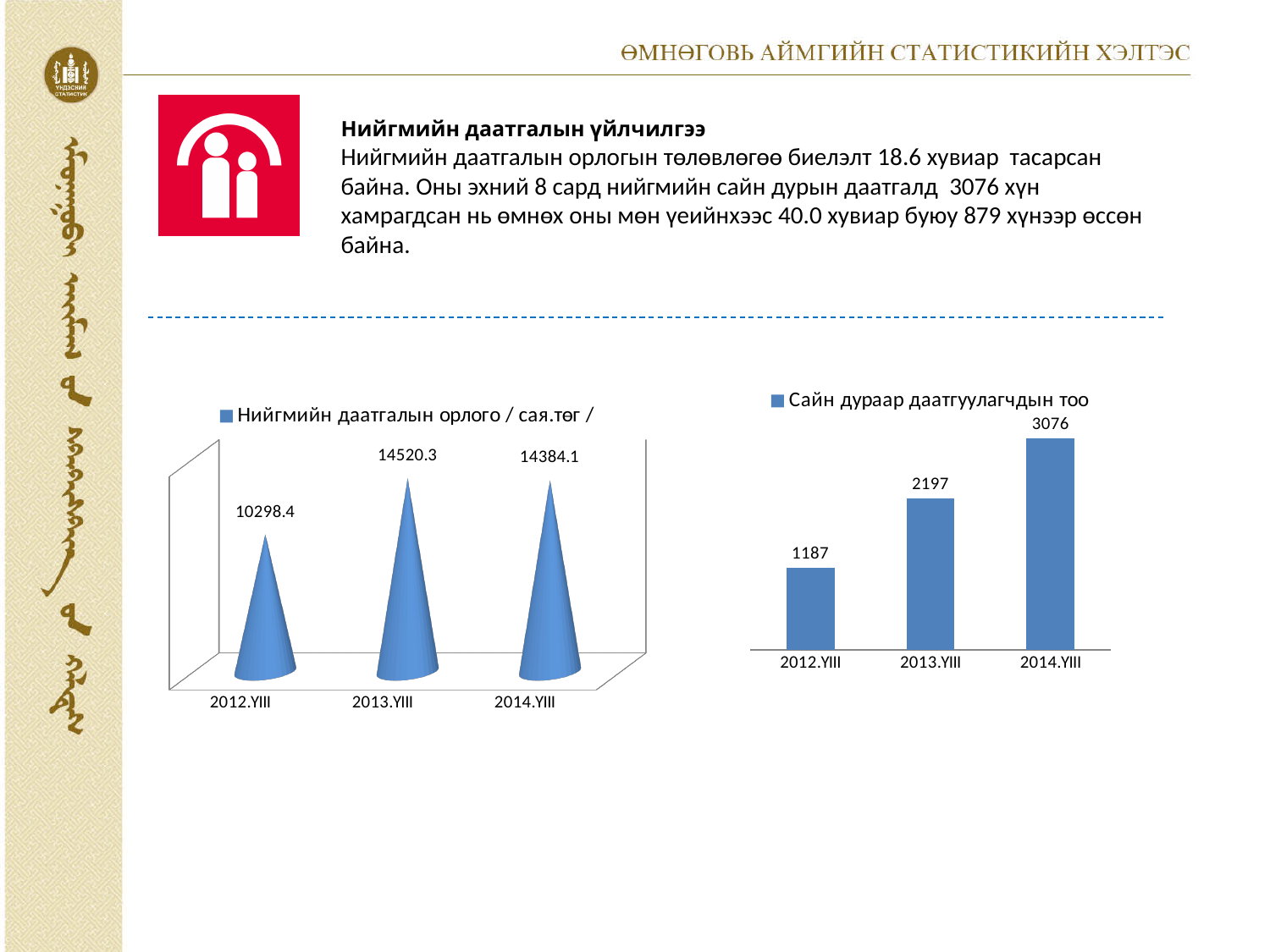
In the left chart (Нийгмийн даатгалын орлого / сая.төг /), which period has the lowest value? 2012.YIII In the left chart (Нийгмийн даатгалын орлого / сая.төг /), which period has the highest value? 2013.YIII In the right chart (Сайн дураар даатгуулагчдын тоо), what is the value for 2012.YIII? 1187 In the right chart (Сайн дураар даатгуулагчдын тоо), what is the difference between the values for 2014.YIII and 2013.YIII? 879 In the left chart (Нийгмийн даатгалын орлого / сая.төг /), how many series does the legend list? 1 What kind of chart is the right chart (Сайн дураар даатгуулагчдын тоо)? bar chart In the left chart (Нийгмийн даатгалын орлого / сая.төг /), what is the value for 2012.YIII? 10298.4 In the right chart (Сайн дураар даатгуулагчдын тоо), what is the value for 2014.YIII? 3076 In the right chart (Сайн дураар даатгуулагчдын тоо), do the values rise or fall from 2012.YIII to 2014.YIII? rise In the right chart (Сайн дураар даатгуулагчдын тоо), how many periods are shown? 3 In the left chart (Нийгмийн даатгалын орлого / сая.төг /), what is the value for 2013.YIII? 14520.3 In the left chart (Нийгмийн даатгалын орлого / сая.төг /), what is the difference between the values for 2013.YIII and 2014.YIII? 136.2